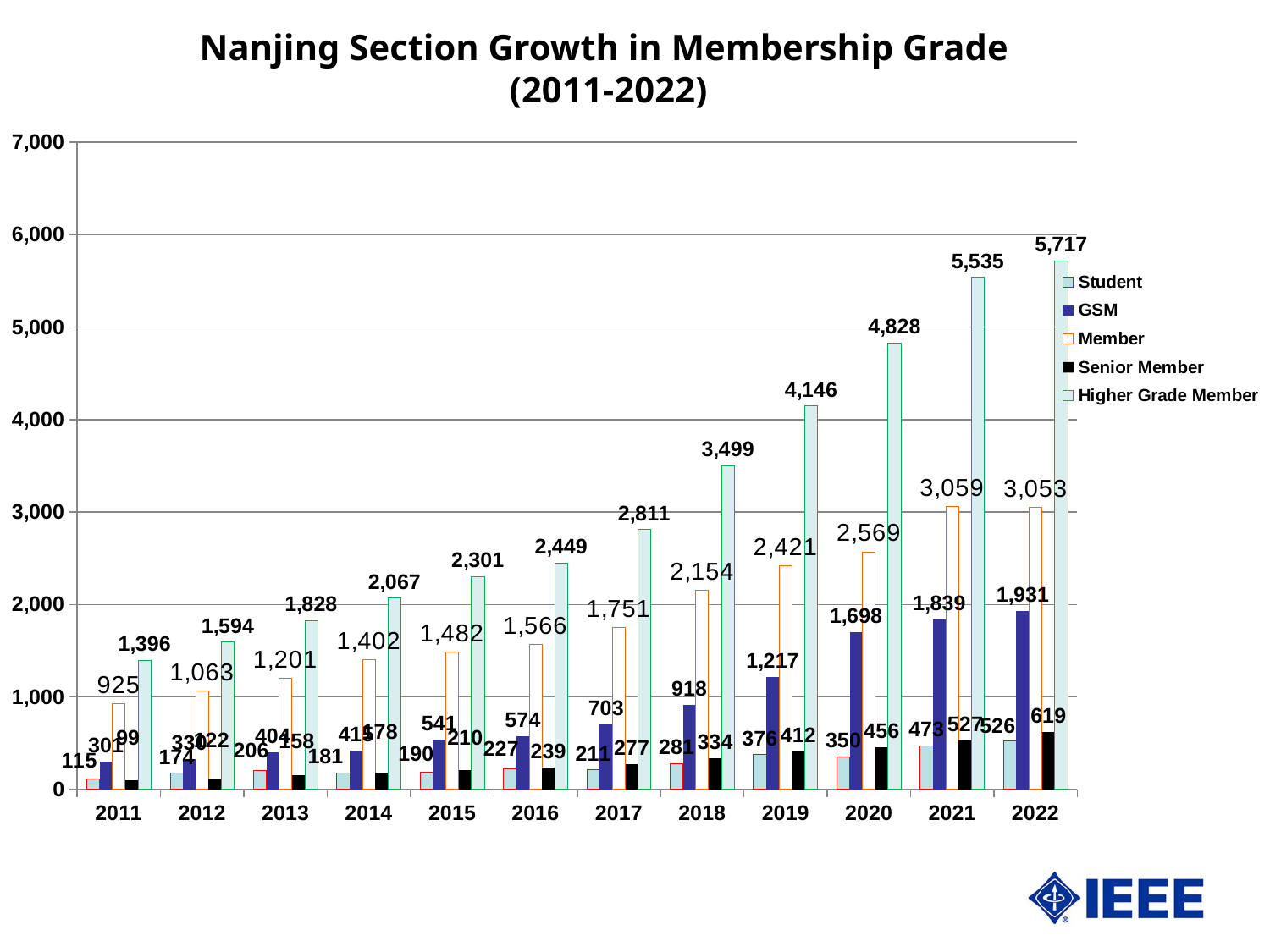
What is the Higher Grade Member value for 2022? 5,717 Is the GSM value for 2022 greater or less than 2,000? less What is the Senior Member value for 2022? 619 What is the GSM value for 2019? 1,217 Which is larger in 2020, the GSM value or the Student value? GSM How many series does the legend list? 5 What is the Member value for 2021? 3,059 Does the Higher Grade Member series rise or fall from 2011 to 2022? Rises What is the difference between the Higher Grade Member values for 2022 and 2021? 182 How many years are shown on the x axis? 12 What kind of chart is shown on the slide? Bar chart In which year is the Higher Grade Member value highest? 2022